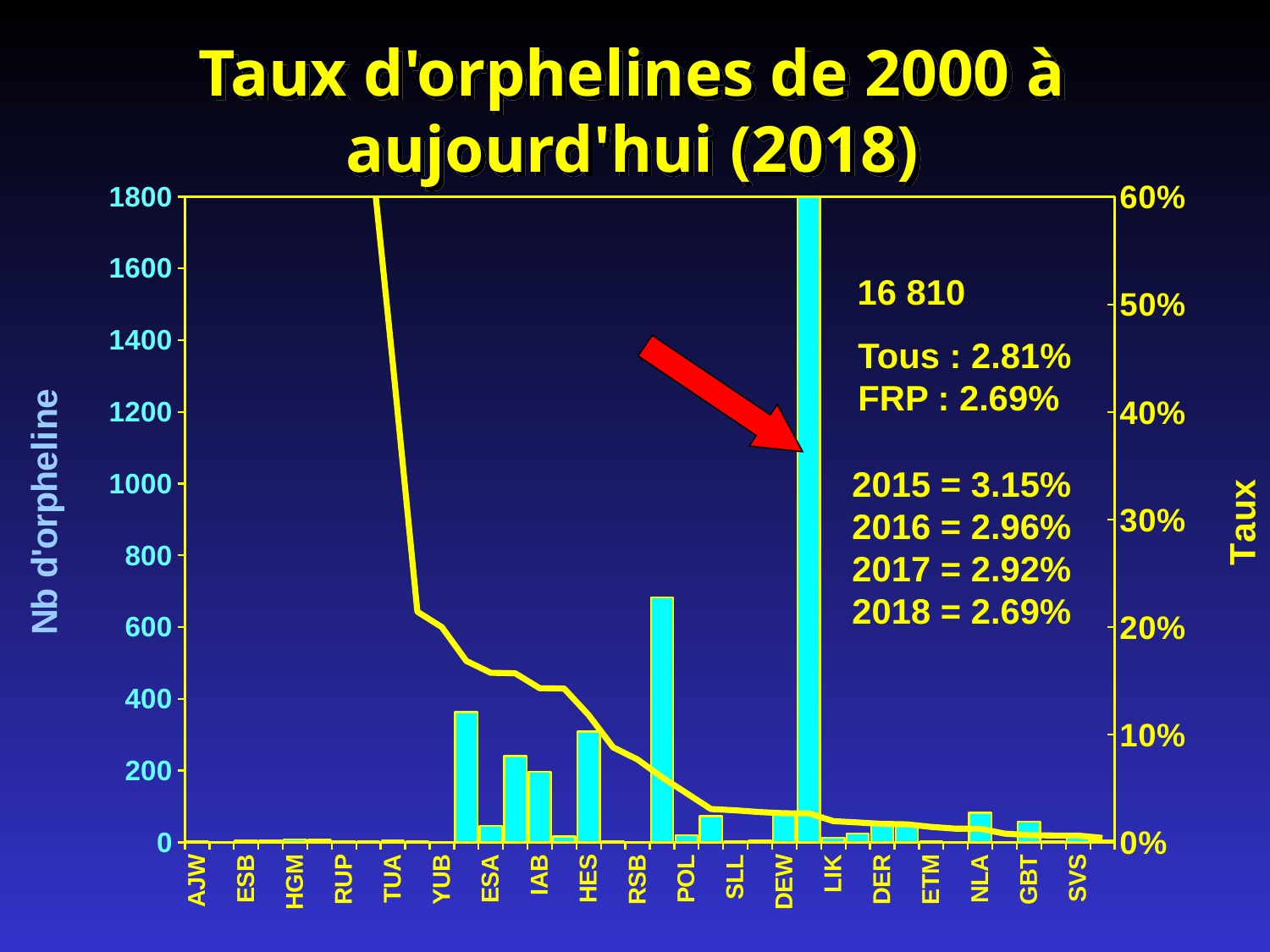
What kind of chart is shown on the slide? A bar chart combined with a line What is the title of the chart? Taux d'orphelines de 2000 à aujourd'hui (2018) Is the tallest cyan bar (the one the red arrow points to) greater or less than 1600 on the left axis? greater According to the text on the chart, what was the rate in 2015? 3.15% Is the yellow line's value at YUB greater or less than 10%? greater Is the yellow line's value at SVS greater or less than 10%? less Of the years 2015 to 2018 listed on the chart, which has the highest rate? 2015 What is the title of the left vertical axis? Nb d'orpheline Does the yellow line rise or fall from left to right across the x axis? Fall According to the text on the chart, what was the rate in 2018? 2.69%